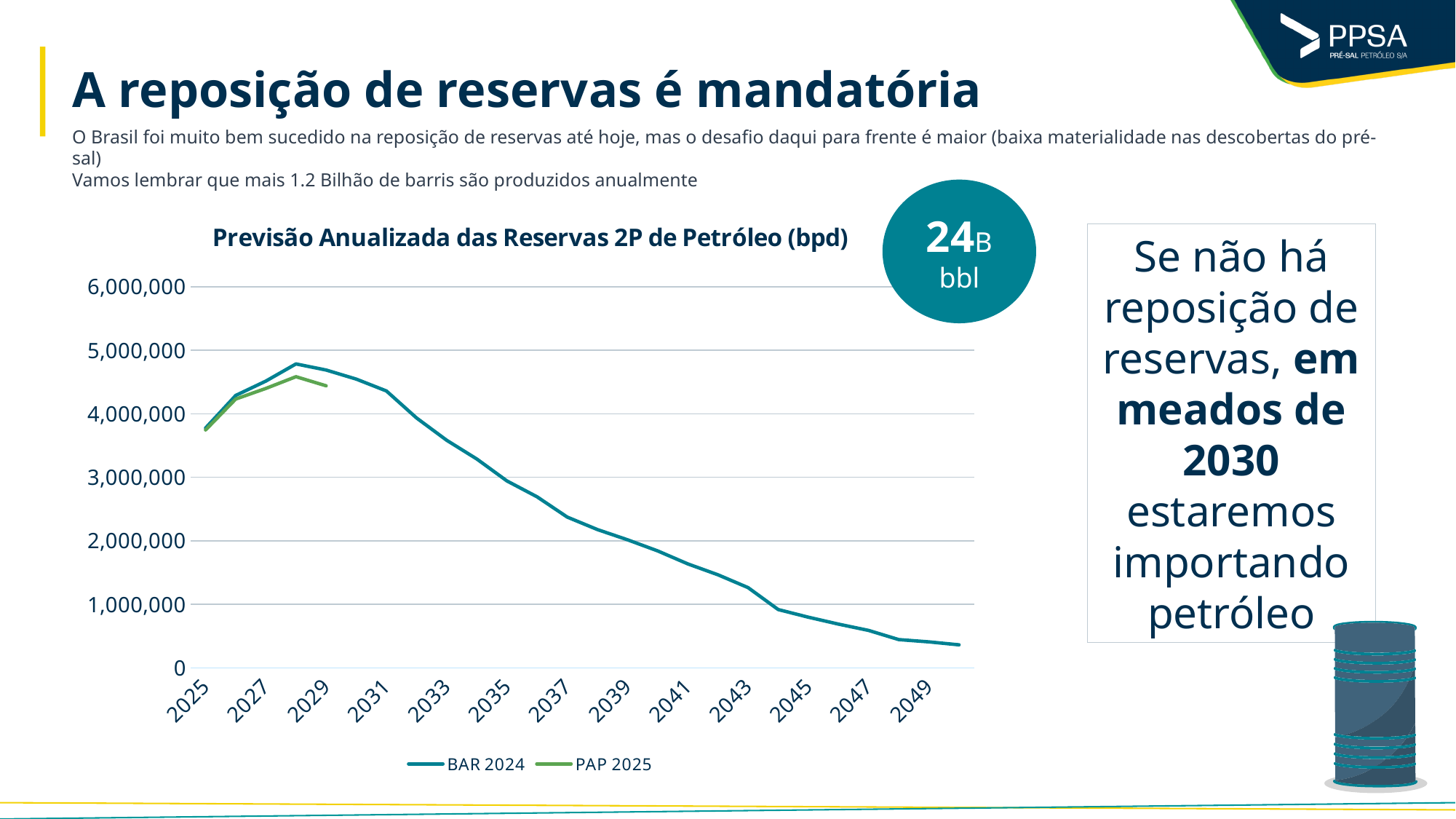
Is the BAR 2024 value for 2049 greater or less than 1,000,000? less At its peak around 2028, which series is higher, BAR 2024 or PAP 2025? BAR 2024 Is the peak value of the BAR 2024 series greater or less than 5,000,000? less Is the BAR 2024 value for 2037 greater or less than 2,000,000? greater What kind of chart is shown on the slide? line chart Does the BAR 2024 series rise or fall between 2031 and 2049? fall What is the title of the chart? Previsão Anualizada das Reservas 2P de Petróleo (bpd) What are the two series named in the chart legend? BAR 2024 and PAP 2025 How many series does the chart legend list? 2